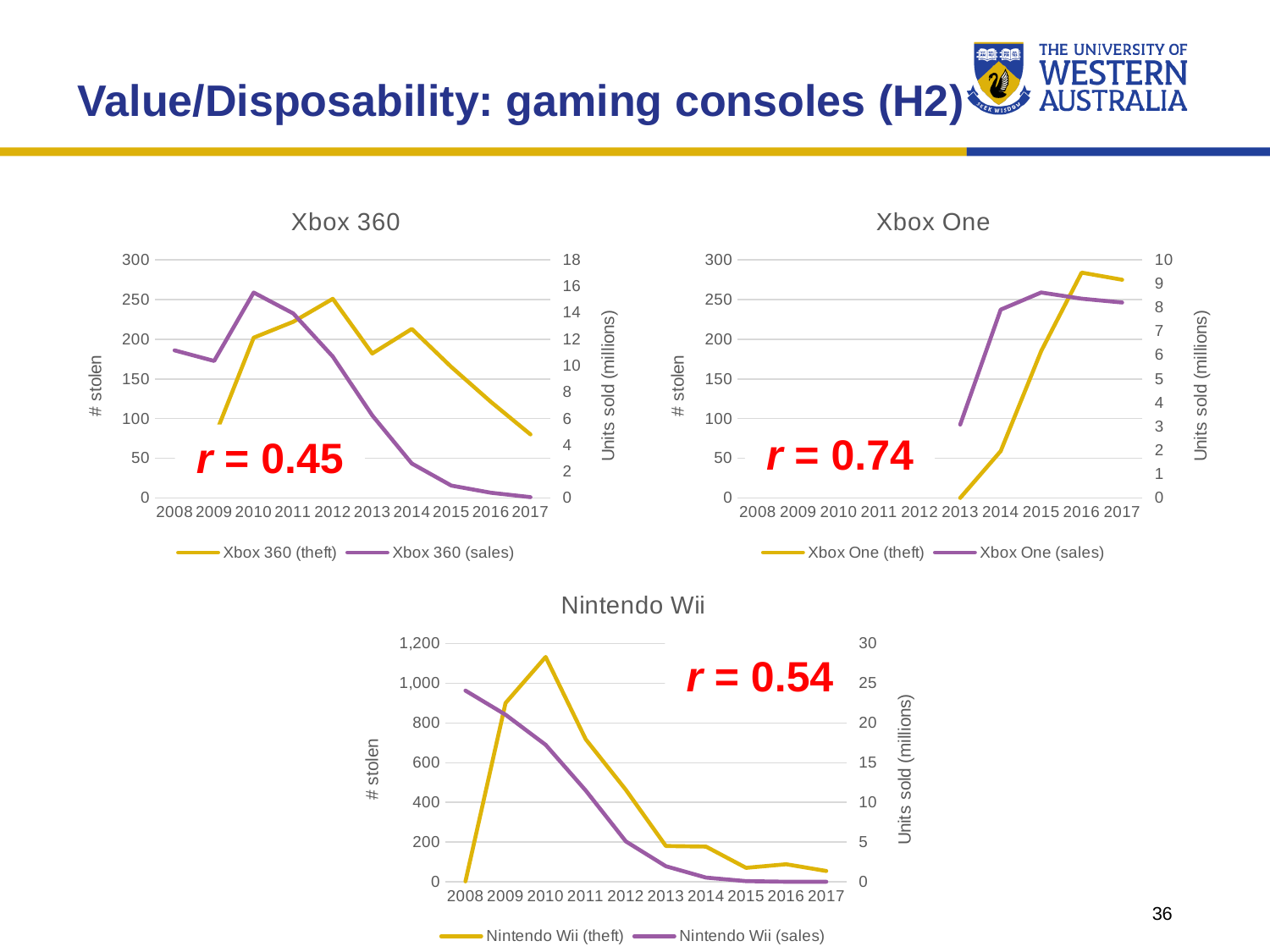
In the Nintendo Wii chart, in which year does the Nintendo Wii (theft) line peak? 2010 In the Nintendo Wii chart, is the Nintendo Wii (theft) value for 2010 greater or less than 1,000? greater How many series does the legend of the Xbox 360 chart list? 2 In the Xbox One chart, is the Xbox One (theft) value for 2014 greater or less than 100? less What kind of chart is the Xbox 360 chart? line chart In the Xbox 360 chart, is the Xbox 360 (theft) value for 2012 greater or less than 200? greater In the Xbox 360 chart, which is larger: the Xbox 360 (theft) value for 2012 or for 2017? 2012 In the Nintendo Wii chart, does the Nintendo Wii (sales) line rise or fall from 2008 to 2017? fall How many years are shown on the x axis of the Nintendo Wii chart? 10 What r value is printed on the Xbox One chart? r = 0.74 In the Xbox 360 chart, in which year does the Xbox 360 (theft) line reach its highest value? 2012 In the Xbox One chart, in which year does the Xbox One (theft) line reach its highest value? 2016